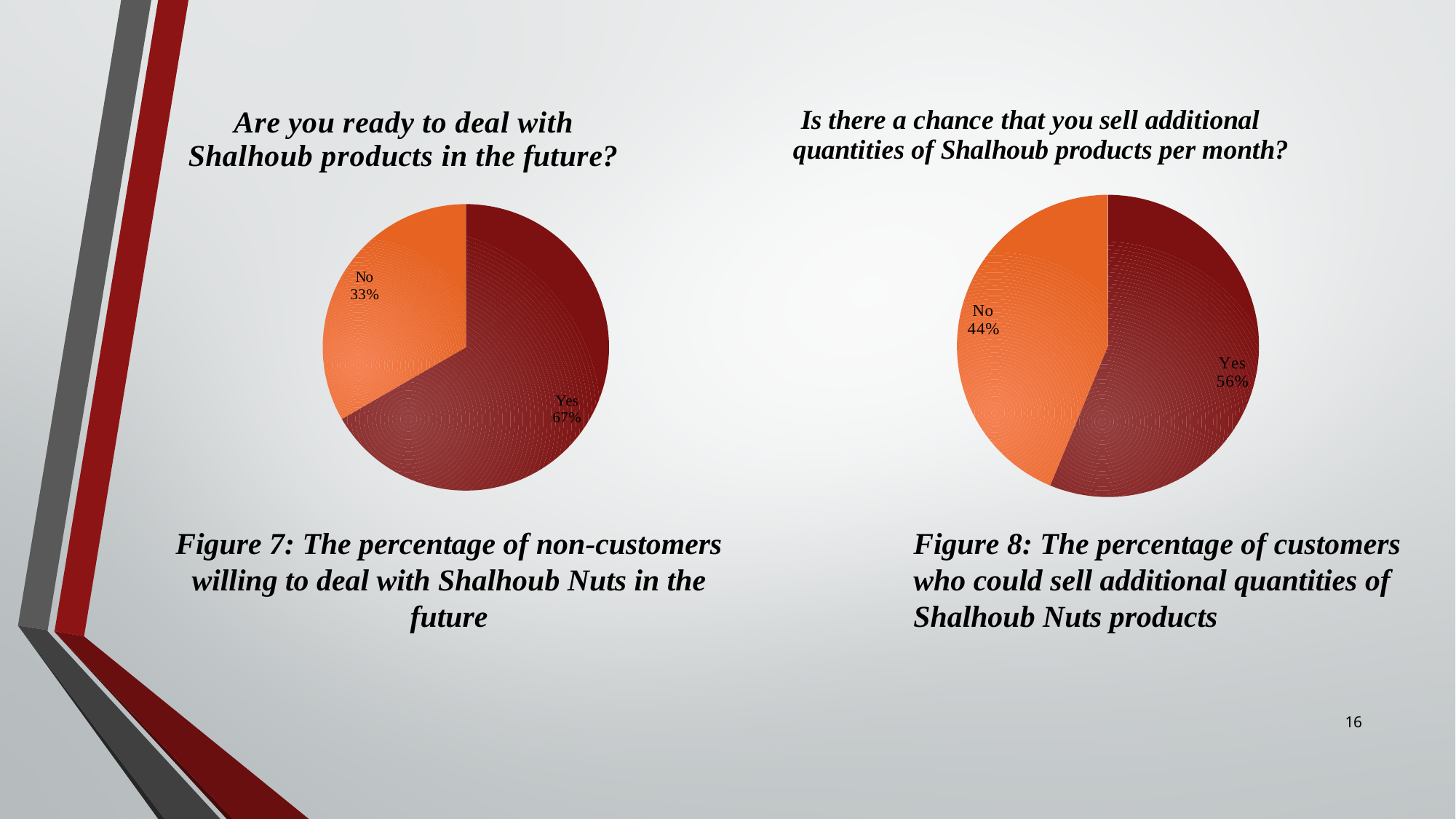
In the left chart titled 'Are you ready to deal with Shalhoub products in the future?', what percentage answered No? 33% In the right chart (Figure 8), which response has the smallest share? No In the left chart (Figure 7), what is the difference between the Yes and No percentages? 34% In the left chart (Figure 7), what colour is the Yes slice? Dark red How many slices does the left chart (Figure 7) have? 2 In the left chart (Figure 7), which response has the largest share? Yes In the right chart (Figure 8), what is the difference between the Yes and No percentages? 12% What type of chart is used in Figure 8 on the right? Pie chart In the right chart titled 'Is there a chance that you sell additional quantities of Shalhoub products per month?', what percentage answered Yes? 56% In the right chart (Figure 8), which is larger, the Yes share or the No share? Yes In the right chart titled 'Is there a chance that you sell additional quantities of Shalhoub products per month?', what percentage answered No? 44% In the left chart titled 'Are you ready to deal with Shalhoub products in the future?', what percentage answered Yes? 67%